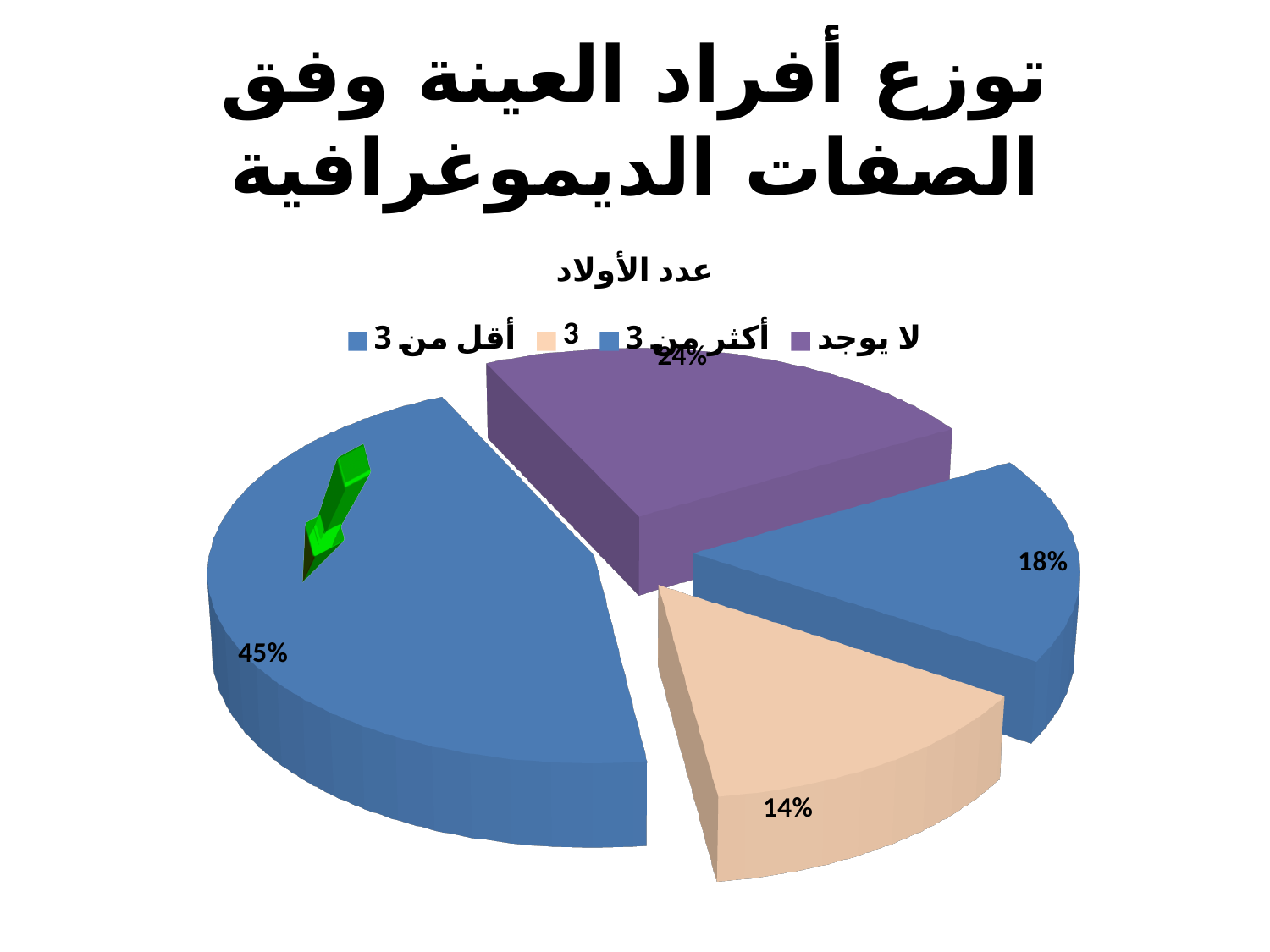
What is the difference between the largest slice (45%) and the smallest slice (14%)? 31% What percentage is shown for the category 3? 14% What is the difference between the 24% slice and the 18% slice? 6% What is the largest percentage shown on the pie chart? 45% What colour is the slice for the category لا يوجد? purple Which is larger, the share for لا يوجد or the share for 3? لا يوجد Which category has the smallest share of the pie? 3 How many entries does the legend list? 4 What percentage is shown for the category لا يوجد? 24% How many slices does the pie chart have? 4 What kind of chart is shown on the slide? pie chart What is the title of the chart? عدد الأولاد